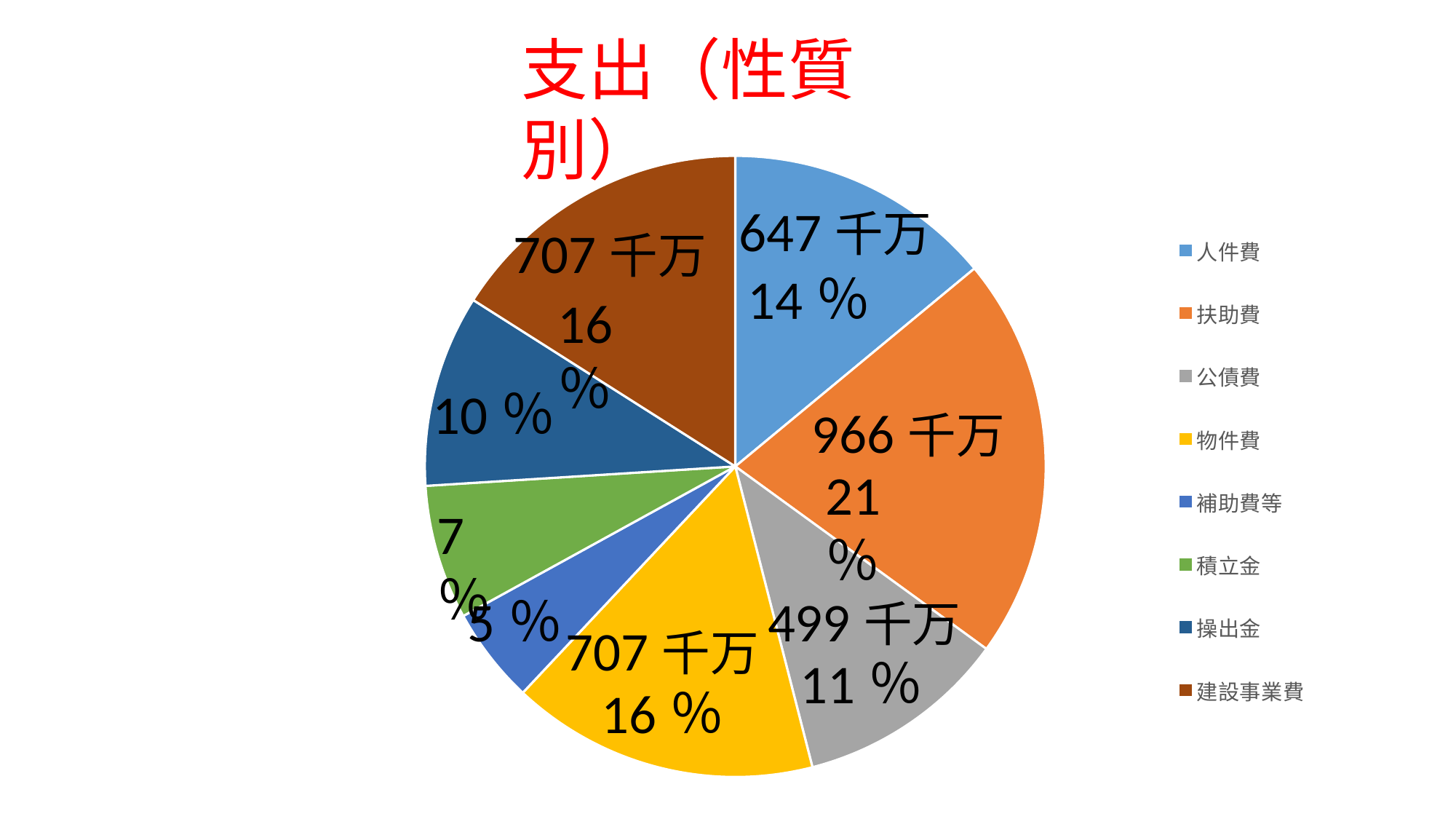
What kind of chart is shown on the slide? pie chart Which is larger, the slice for 人件費 or the slice for 公債費? 人件費 Which category has the largest slice of the pie chart? 扶助費 What percentage share of the pie does 建設事業費 have? 16 % What is the difference between the values for 扶助費 and 人件費? 319 千万 What value is shown for 公債費? 499 千万 What value is shown for 人件費? 647 千万 Which category has the smallest slice of the pie chart? 補助費等 How many categories does the legend of the pie chart list? 8 What percentage share of the pie does 積立金 have? 7 % What value is shown for 扶助費? 966 千万 What percentage share of the pie does 操出金 have? 10 %